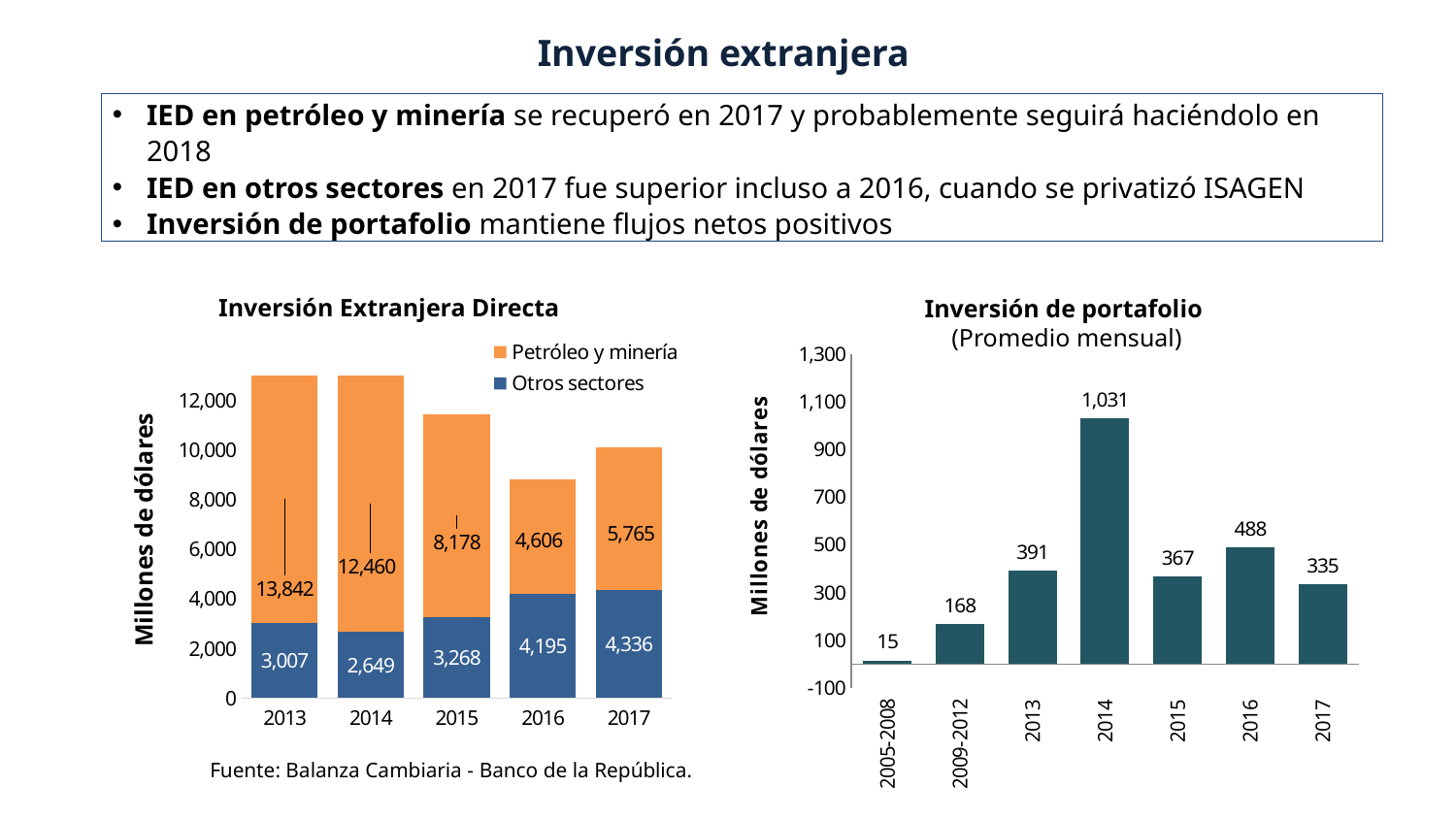
In the 'Inversión Extranjera Directa' chart, what is the value for Petróleo y minería in 2015? 8,178 In the 'Inversión Extranjera Directa' chart, what is the total of the stacked bar for 2016? 8,801 In the 'Inversión de portafolio' chart, which is larger, the value for 2016 or the value for 2017? 2016 In the 'Inversión Extranjera Directa' chart, how many series does the legend list? 2 In the 'Inversión Extranjera Directa' chart, what is the value for Otros sectores in 2017? 4,336 In the 'Inversión Extranjera Directa' chart, which year has the lowest value for Otros sectores? 2014 In the 'Inversión de portafolio' chart, how many categories are shown on the x axis? 7 In the 'Inversión de portafolio' chart, what is the value for 2014? 1,031 In the 'Inversión Extranjera Directa' chart, what is the difference between Petróleo y minería in 2013 and in 2014? 1,382 In the 'Inversión Extranjera Directa' chart, which series is shown in orange? Petróleo y minería In the 'Inversión de portafolio' chart, which category has the lowest value? 2005-2008 What kind of chart is the 'Inversión de portafolio' chart? Bar chart